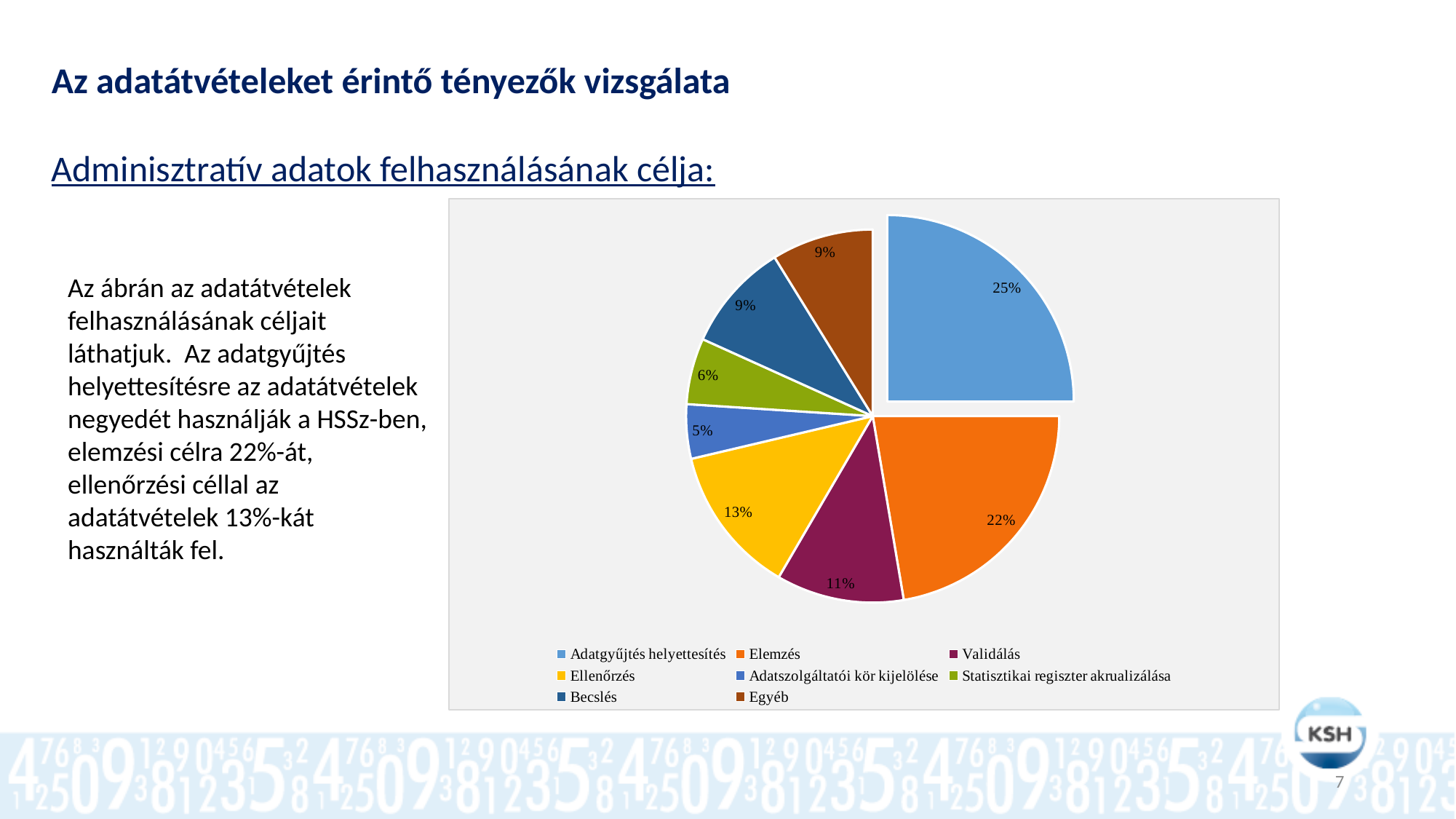
What share of the pie does Ellenőrzés have? 13% What share of the pie does Validálás have? 11% What share of the pie does Statisztikai regiszter akrualizálása have? 6% Which category has the smallest slice of the pie? Adatszolgáltatói kör kijelölése How many categories does the legend of the pie chart list? 8 What is the difference in percentage points between Adatgyűjtés helyettesítés and Elemzés? 3 percentage points Which is larger, the share for Ellenőrzés or the share for Validálás? Ellenőrzés Which category has the largest slice of the pie? Adatgyűjtés helyettesítés What kind of chart is shown on the slide? pie chart